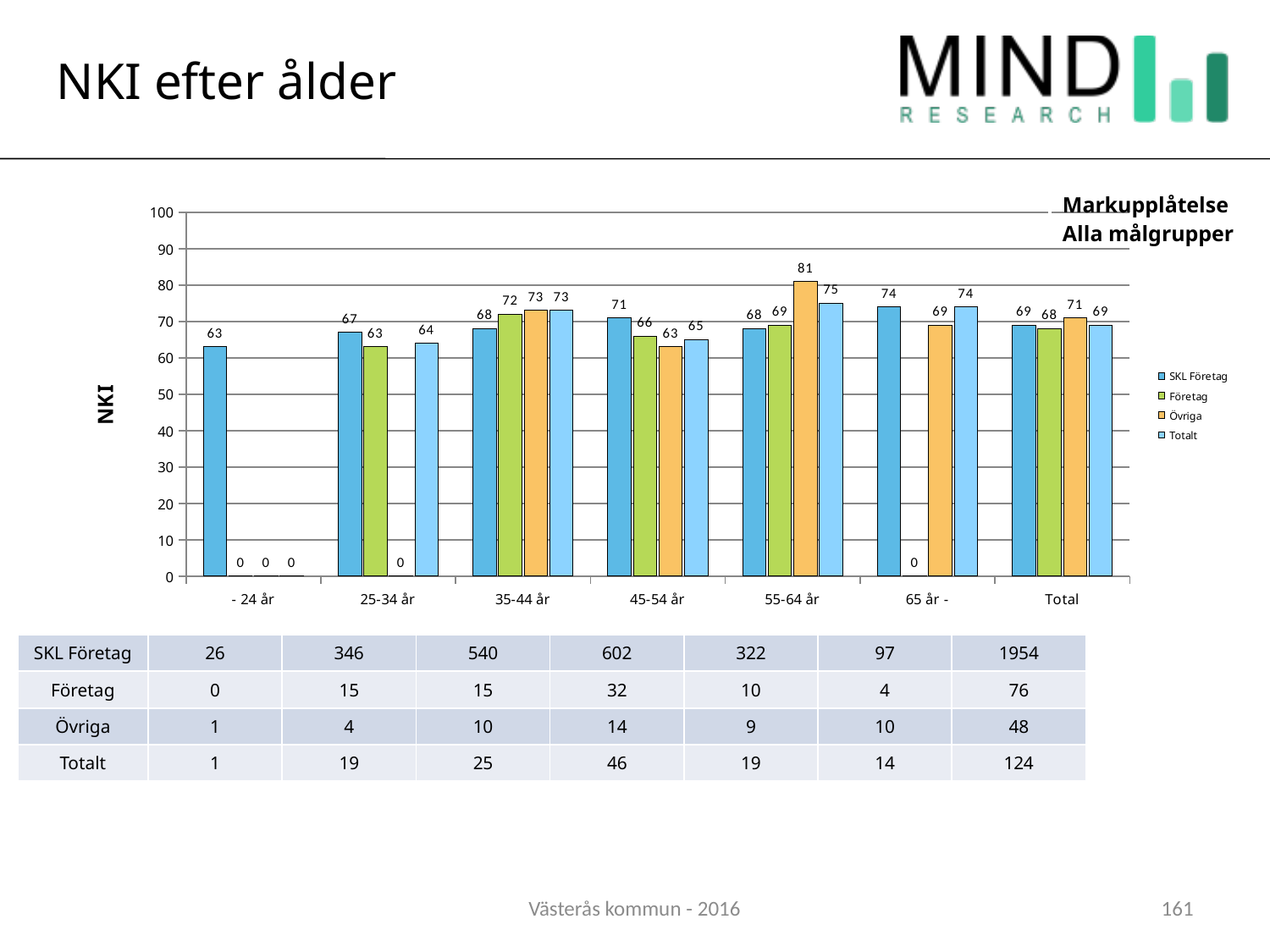
What is the difference between the Övriga and SKL Företag values in the 55-64 år age group? 13 How many age categories are shown on the x axis, including Total? 7 Which is larger in the 45-54 år age group: SKL Företag or Företag? SKL Företag What type of chart is shown on the slide? Bar chart Which age group has the highest Totalt NKI value? 55-64 år How many series does the legend list? 4 Which age group has the lowest SKL Företag NKI value? - 24 år What is the NKI value for SKL Företag in the 55-64 år age group? 68 What is the Totalt NKI value for the 35-44 år age group? 73 What is the NKI value for Övriga in the 55-64 år age group? 81 What is the label on the vertical axis of the chart? NKI What is the NKI value for Företag in the Total category? 68